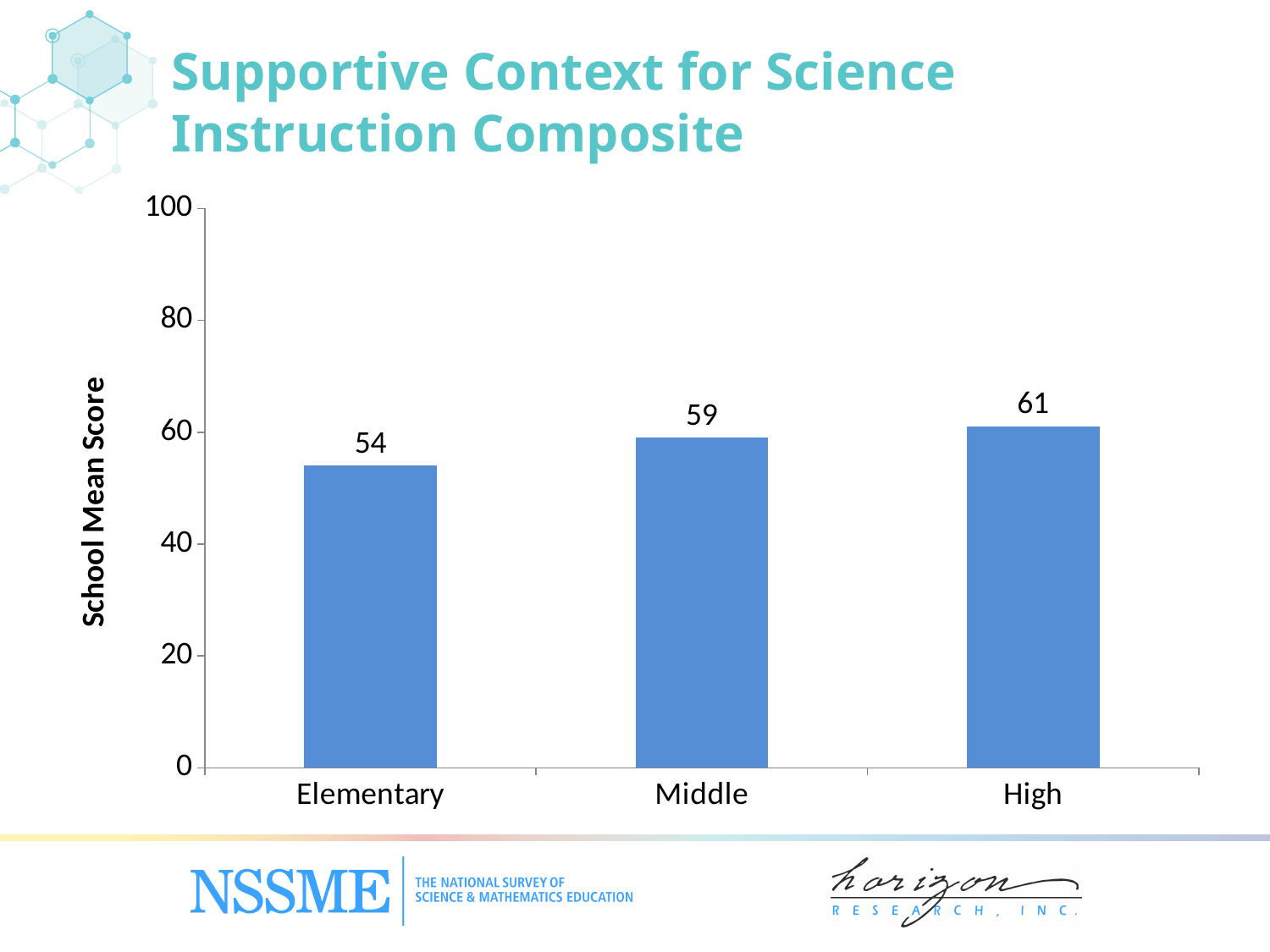
Which school level has the lowest school mean score? Elementary What is the school mean score for Elementary? 54 Which has a larger school mean score, Elementary or Middle? Middle How many school levels are shown on the chart? 3 Is the value for Elementary greater or less than 60? less What is the difference between the school mean scores for Middle and Elementary? 5 What kind of chart is shown on the slide? bar chart What is the school mean score for High? 61 What is the school mean score for Middle? 59 Which school level has the highest school mean score? High What is the difference between the school mean scores for High and Elementary? 7 What is the label of the vertical axis? School Mean Score